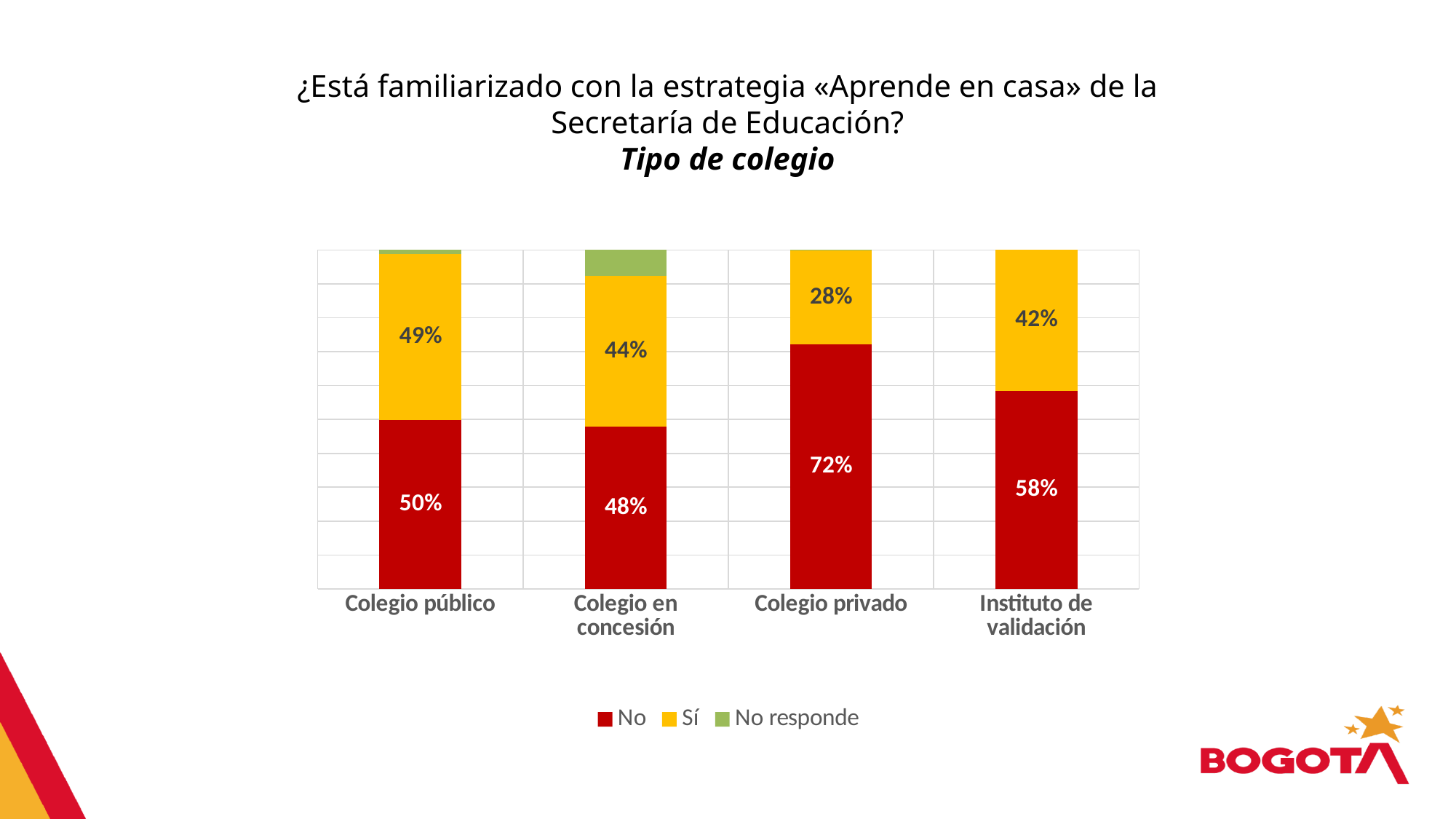
What is the "Sí" value for Colegio público? 49% How many types of school are shown on the x axis? 4 How many series does the legend list? 3 What is the "No" value for Instituto de validación? 58% What is the difference in percentage points between the "No" value for Colegio privado and the "No" value for Colegio público? 22 Which type of school has the lowest "Sí" percentage? Colegio privado What percentage of respondents from Colegio privado answered "No"? 72% What is the "Sí" value for Colegio en concesión? 44% What kind of chart is shown on the slide? Stacked bar chart Which type of school has the highest "No" percentage? Colegio privado Which is larger: the "Sí" value for Colegio en concesión or the "Sí" value for Instituto de validación? Colegio en concesión Which type of school has the lowest "No" percentage? Colegio en concesión